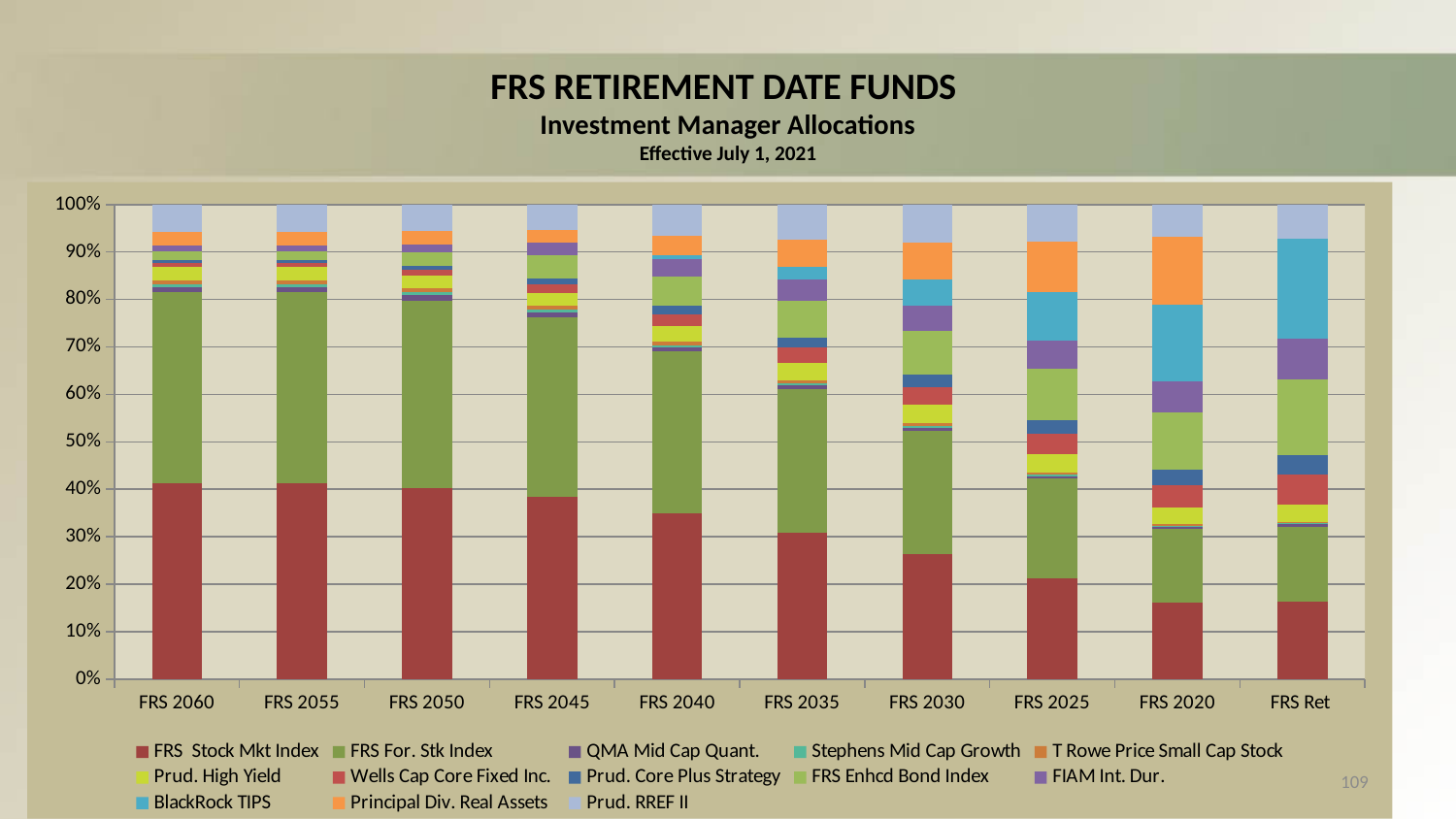
Moving along the x axis from FRS 2060 to FRS Ret, does the FRS Stock Mkt Index allocation rise or fall? fall What kind of chart is shown on the slide? Stacked bar chart As of what date are the investment manager allocations effective? July 1, 2021 How many funds (categories) are shown along the x axis? 10 How many investment managers (series) does the legend list? 13 Is the FRS Stock Mkt Index allocation for FRS Ret greater or less than 20%? less Is the FRS Stock Mkt Index allocation for FRS 2020 greater or less than 20%? less Is the FRS Stock Mkt Index allocation for FRS 2030 greater or less than 20%? greater Which fund has the larger BlackRock TIPS allocation, FRS 2060 or FRS Ret? FRS Ret What is the title of the chart on the slide? FRS RETIREMENT DATE FUNDS Which fund has the larger FRS Stock Mkt Index allocation, FRS 2060 or FRS Ret? FRS 2060